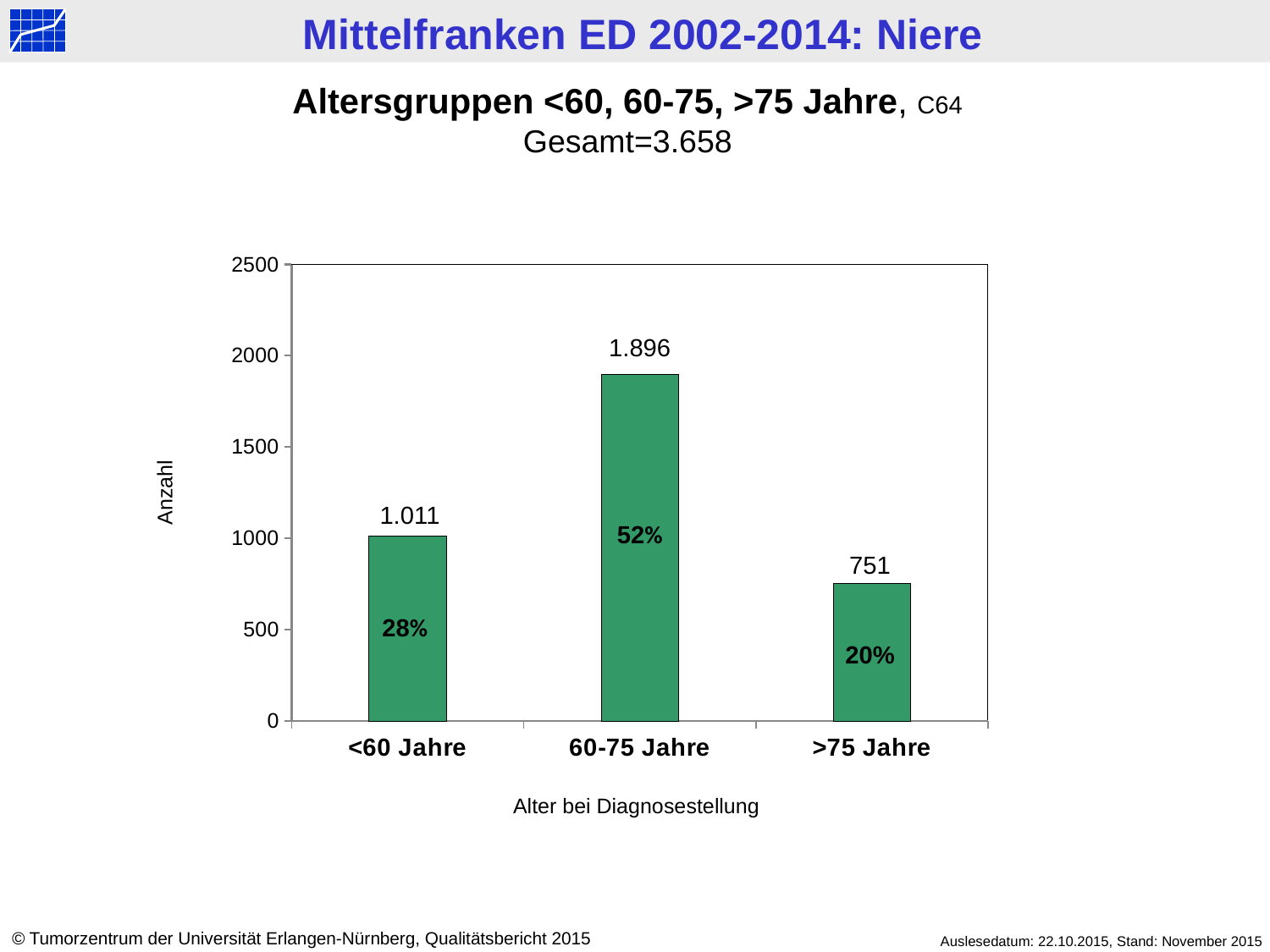
Which is larger, the value for <60 Jahre or the value for >75 Jahre? <60 Jahre What kind of chart is shown on the slide? bar chart What is the value for the >75 Jahre age group? 751 What is the difference between the values for 60-75 Jahre and <60 Jahre? 885 How many age groups are shown on the x axis? 3 What is the value for the 60-75 Jahre age group? 1.896 What percentage is shown on the bar for the >75 Jahre age group? 20% What is the value for the <60 Jahre age group? 1.011 What is the label of the y axis? Anzahl Is the value for 60-75 Jahre greater or less than 1500? greater Which age group has the lowest value? >75 Jahre Which age group has the highest value? 60-75 Jahre